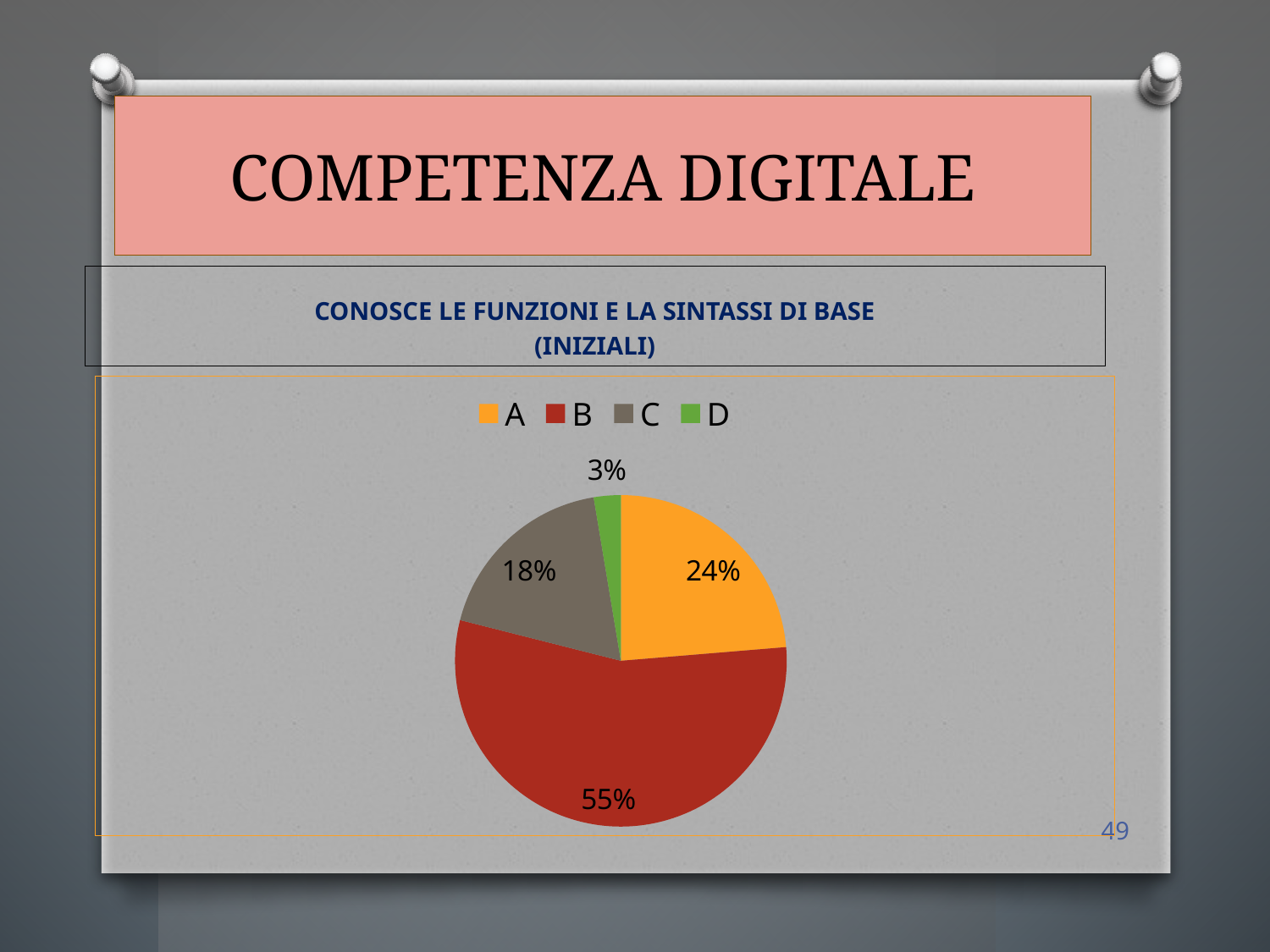
What percentage does slice A represent? 24% Which category has the smallest share of the pie? D What percentage does slice B represent? 55% What is the difference in percentage points between slice B and slice A? 31 How many entries does the legend list? 4 What percentage does slice D represent? 3% What kind of chart is shown on the slide? pie chart What percentage does slice C represent? 18% Which is larger, slice A or slice C? A Which category has the largest share of the pie? B How many slices does the pie chart have? 4 What colour is the slice for category B? red